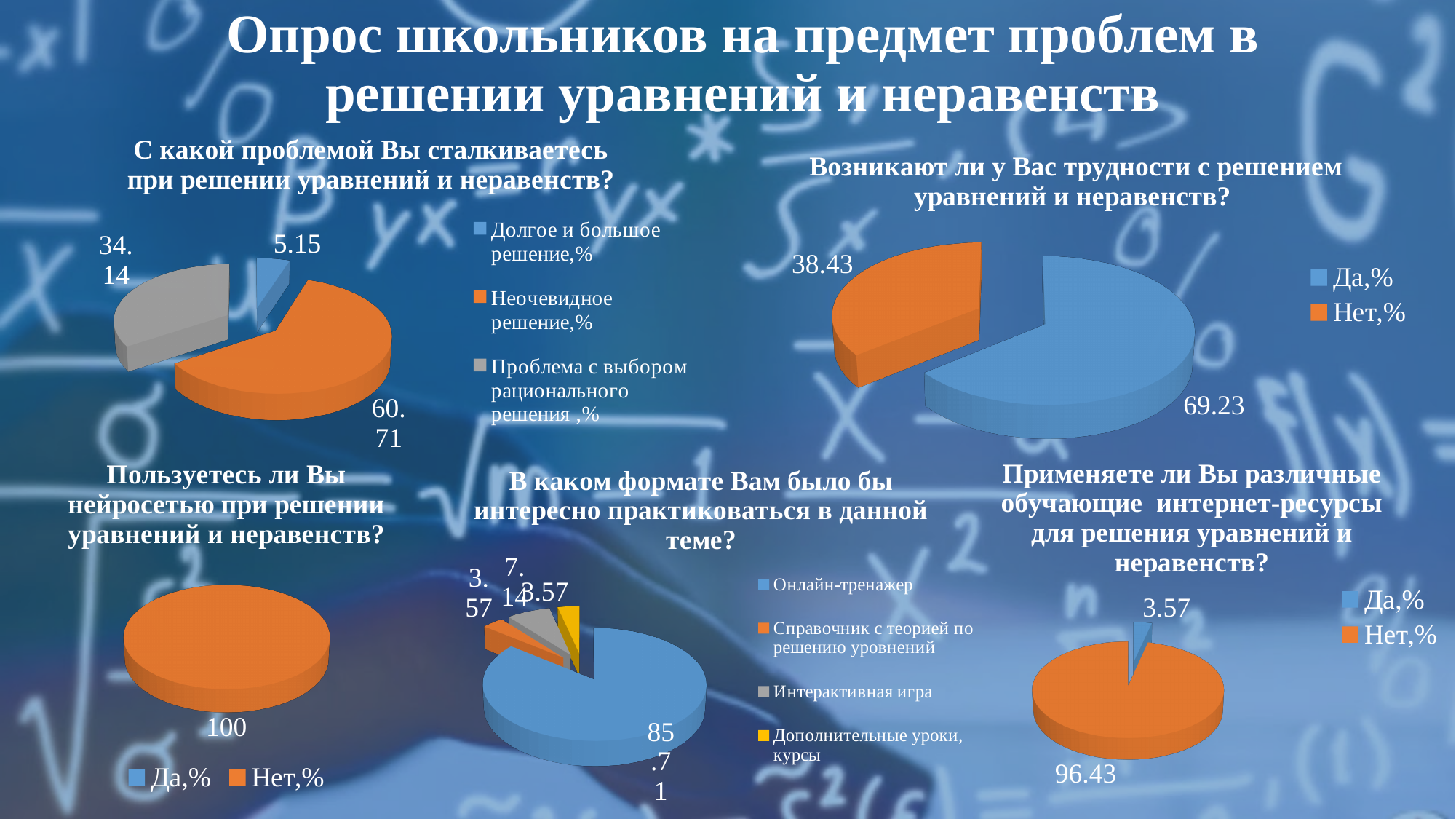
In the chart 'С какой проблемой Вы сталкиваетесь при решении уравнений и неравенств?', what is the value for 'Неочевидное решение,%'? 60.71 In the chart 'С какой проблемой Вы сталкиваетесь при решении уравнений и неравенств?', which category has the smallest slice? Долгое и большое решение,% In the chart 'В каком формате Вам было бы интересно практиковаться в данной теме?', what is the value for 'Интерактивная игра'? 7.14 In the chart 'Пользуетесь ли Вы нейросетью при решении уравнений и неравенств?', which category does the single slice represent? Нет,% In the chart 'В каком формате Вам было бы интересно практиковаться в данной теме?', how many categories does the legend list? 4 In the chart 'Возникают ли у Вас трудности с решением уравнений и неравенств?', which is larger, 'Да,%' or 'Нет,%'? Да,% In the chart 'С какой проблемой Вы сталкиваетесь при решении уравнений и неравенств?', how many categories does the legend list? 3 In the chart 'Применяете ли Вы различные обучающие интернет-ресурсы для решения уравнений и неравенств?', what is the value for 'Нет,%'? 96.43 In the chart 'Пользуетесь ли Вы нейросетью при решении уравнений и неравенств?', what value is shown on the chart? 100 In the chart 'Возникают ли у Вас трудности с решением уравнений и неравенств?', what is the value for 'Да,%'? 69.23 What type of chart is used for 'Применяете ли Вы различные обучающие интернет-ресурсы для решения уравнений и неравенств?'? Pie chart In the chart 'В каком формате Вам было бы интересно практиковаться в данной теме?', what is the value for 'Онлайн-тренажер'? 85.71